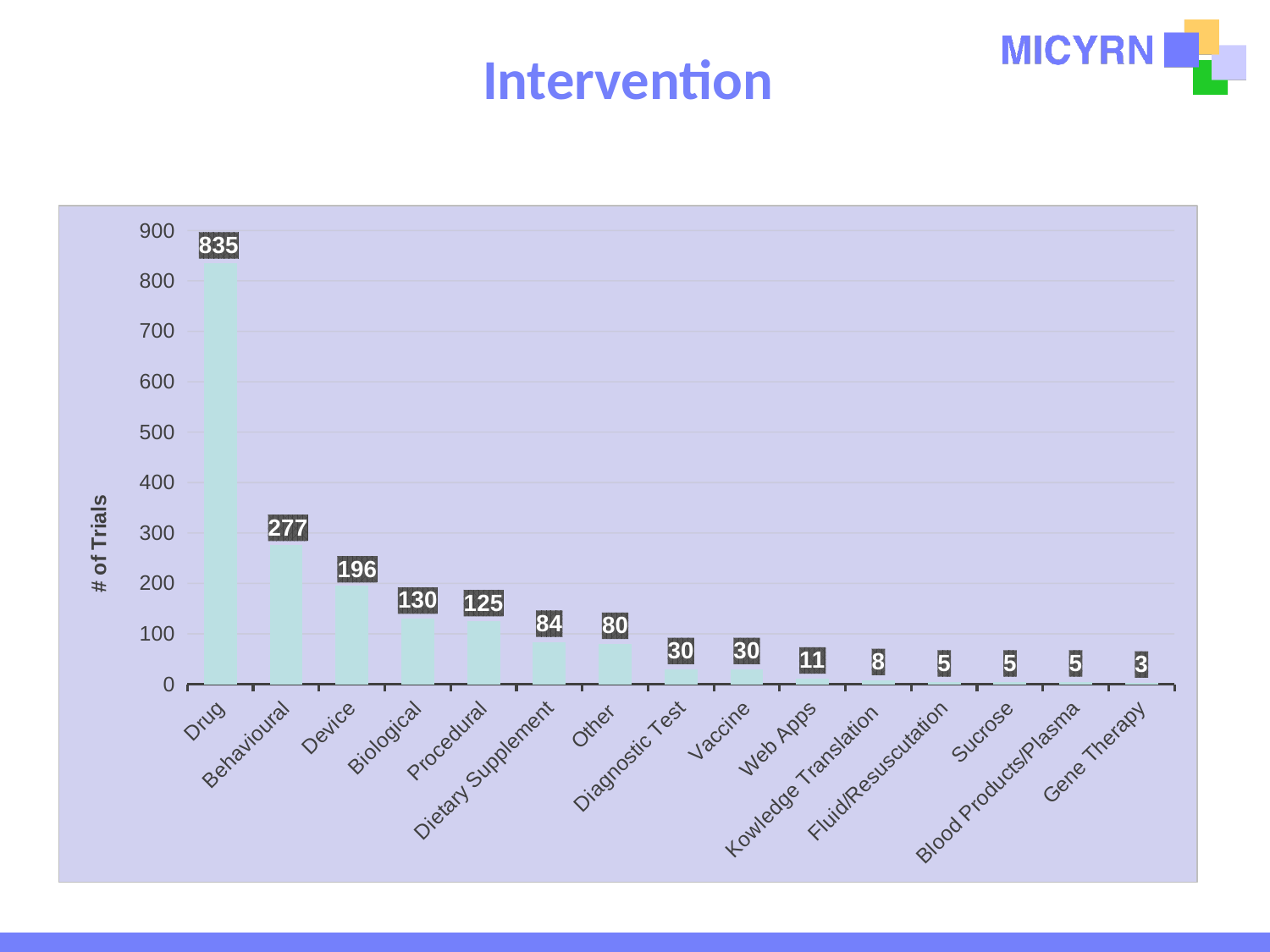
Which intervention category has the lowest number of trials? Gene Therapy Do the values rise or fall moving from left to right along the x axis? Fall What is the value for Web Apps? 11 Which intervention category has the highest number of trials? Drug What is the label of the vertical axis? # of Trials What type of chart is shown on the slide? Bar chart How many trials are shown for Drug? 835 What is the number of trials for Dietary Supplement? 84 Which has more trials, Biological or Procedural? Biological What is the difference between the Drug and Behavioural values? 558 What is the difference in number of trials between Behavioural and Device? 81 How many intervention categories are shown on the x axis? 15